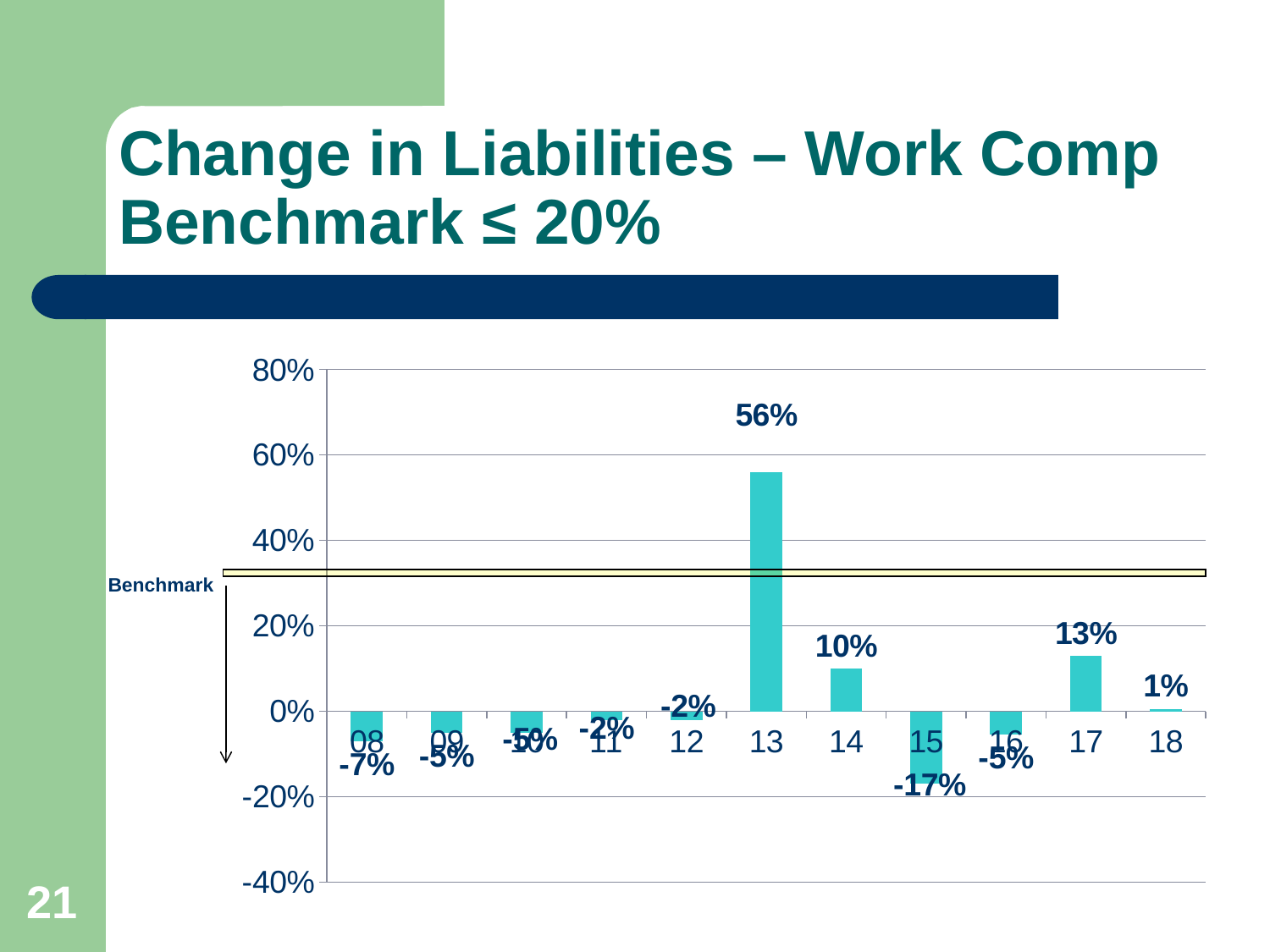
What is the value for 18? 1% What is the value for 15? -17% How many years are shown on the x axis? 11 What is the difference between the values for 13 and 14? 46 percentage points What is the value for 08? -7% Which year has the lowest value? 15 Which is larger, the value for 14 or the value for 17? 17 What kind of chart is shown on the slide? bar chart What is the value for 17? 13% What is the value for 13? 56% Which year has the highest value? 13 Is the value for 13 greater or less than 40%? greater